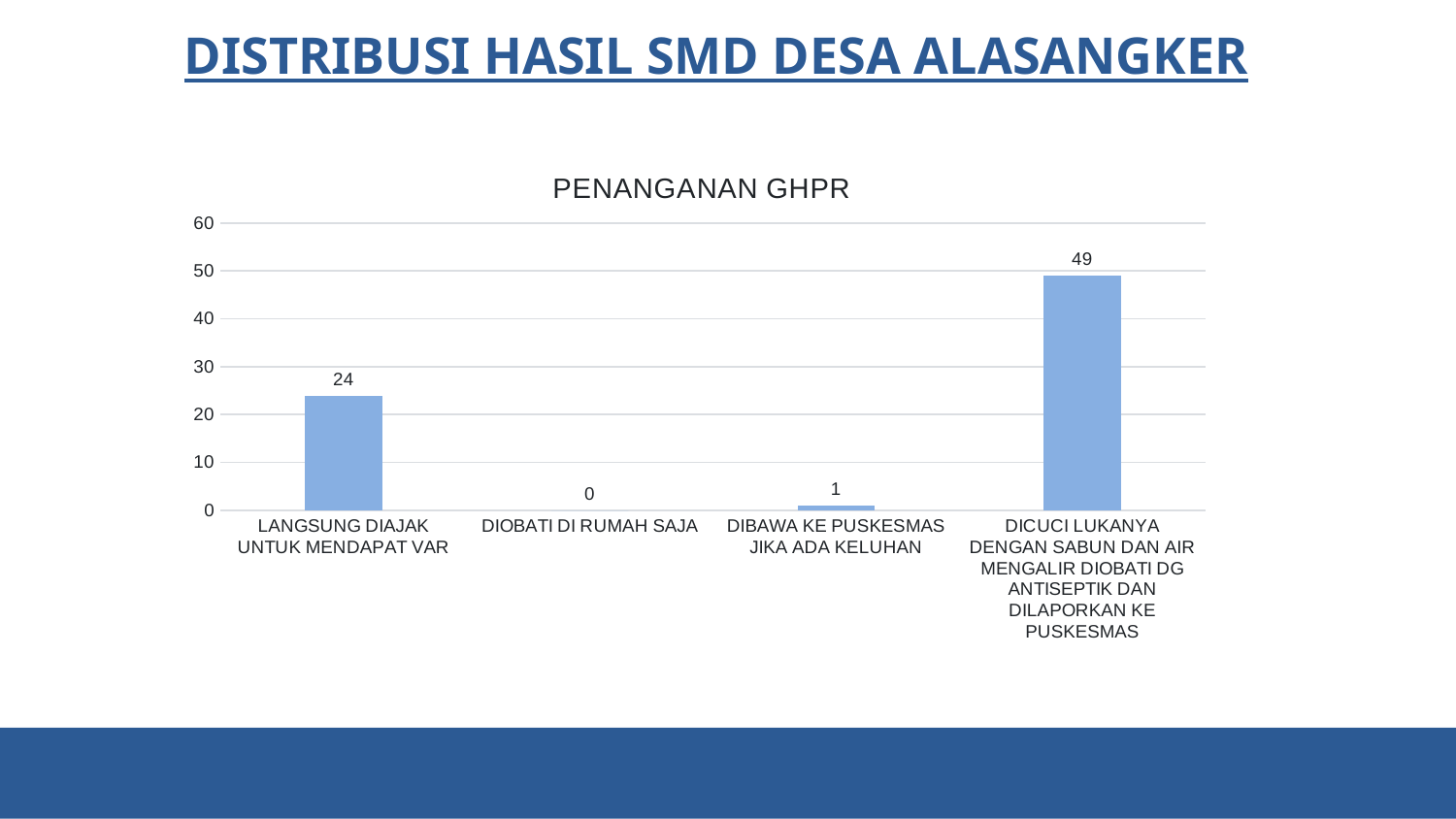
What is the value for the category DICUCI LUKANYA DENGAN SABUN DAN AIR MENGALIR DIOBATI DG ANTISEPTIK DAN DILAPORKAN KE PUSKESMAS? 49 What is the difference between the values for DICUCI LUKANYA DENGAN SABUN DAN AIR MENGALIR DIOBATI DG ANTISEPTIK DAN DILAPORKAN KE PUSKESMAS and LANGSUNG DIAJAK UNTUK MENDAPAT VAR? 25 Which is larger: the value for LANGSUNG DIAJAK UNTUK MENDAPAT VAR or the value for DIBAWA KE PUSKESMAS JIKA ADA KELUHAN? LANGSUNG DIAJAK UNTUK MENDAPAT VAR What kind of chart is shown on the slide? bar chart What is the title of the chart? PENANGANAN GHPR How many categories are shown on the x axis? 4 Which category has the highest value? DICUCI LUKANYA DENGAN SABUN DAN AIR MENGALIR DIOBATI DG ANTISEPTIK DAN DILAPORKAN KE PUSKESMAS What is the value for LANGSUNG DIAJAK UNTUK MENDAPAT VAR? 24 What is the value for DIOBATI DI RUMAH SAJA? 0 What is the value for DIBAWA KE PUSKESMAS JIKA ADA KELUHAN? 1 Is the value for LANGSUNG DIAJAK UNTUK MENDAPAT VAR greater or less than 30? less Which category has the lowest value? DIOBATI DI RUMAH SAJA